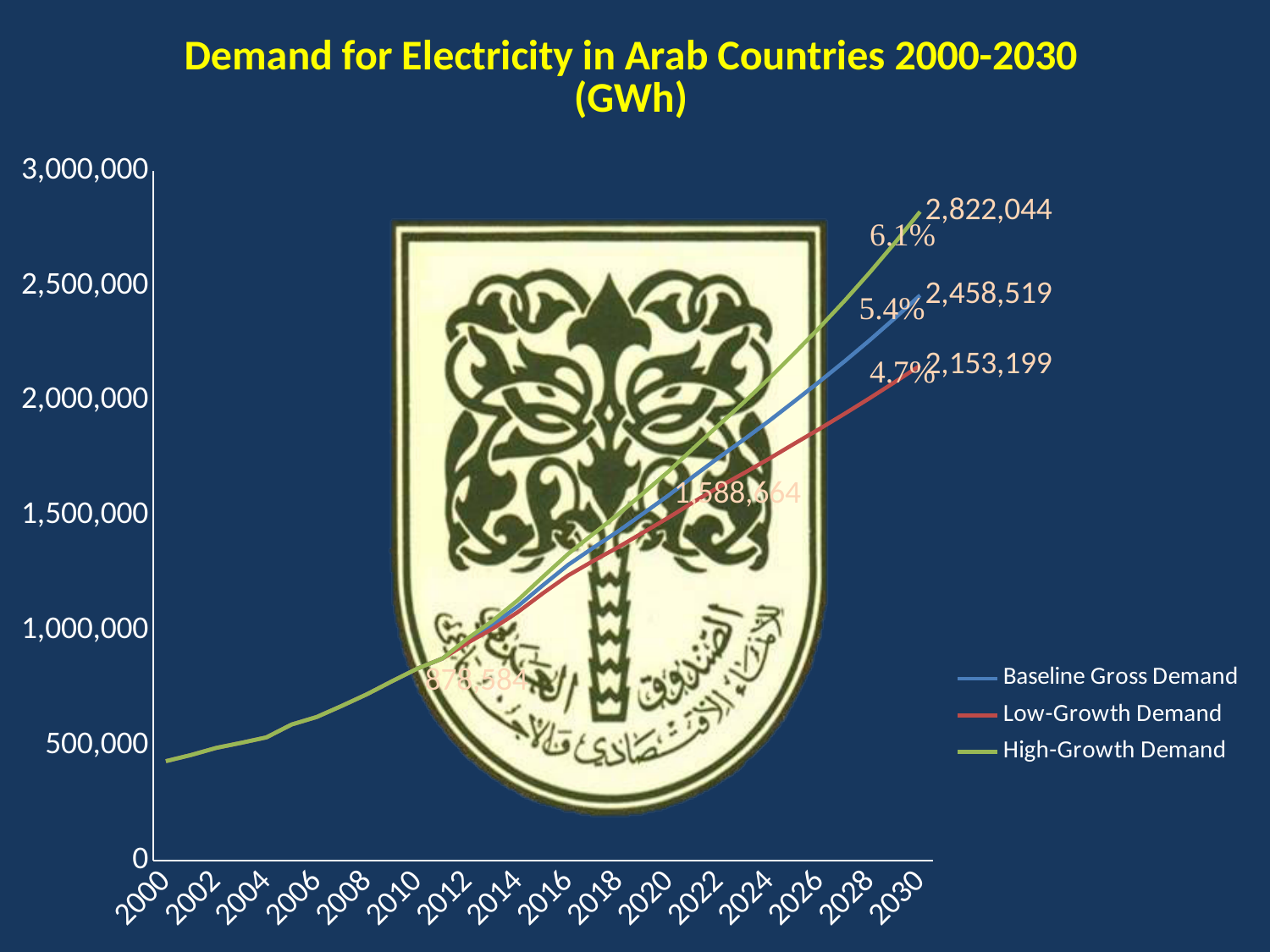
Which series has the highest value in 2030? High-Growth Demand What is the Low-Growth Demand value shown for 2030? 2,153,199 Is the demand value for 2000 greater or less than 500,000? less How many series does the legend list? 3 Which series has the lowest value in 2030? Low-Growth Demand What is the Baseline Gross Demand value shown for 2030? 2,458,519 What is the High-Growth Demand value shown for 2030? 2,822,044 What is the difference between the High-Growth Demand and Low-Growth Demand values in 2030? 668,845 What is the difference between the Baseline Gross Demand and Low-Growth Demand values in 2030? 305,320 Do the demand values rise or fall from 2000 to 2030? rise What kind of chart is shown on the slide? line chart In 2030, which is larger: Baseline Gross Demand or Low-Growth Demand? Baseline Gross Demand